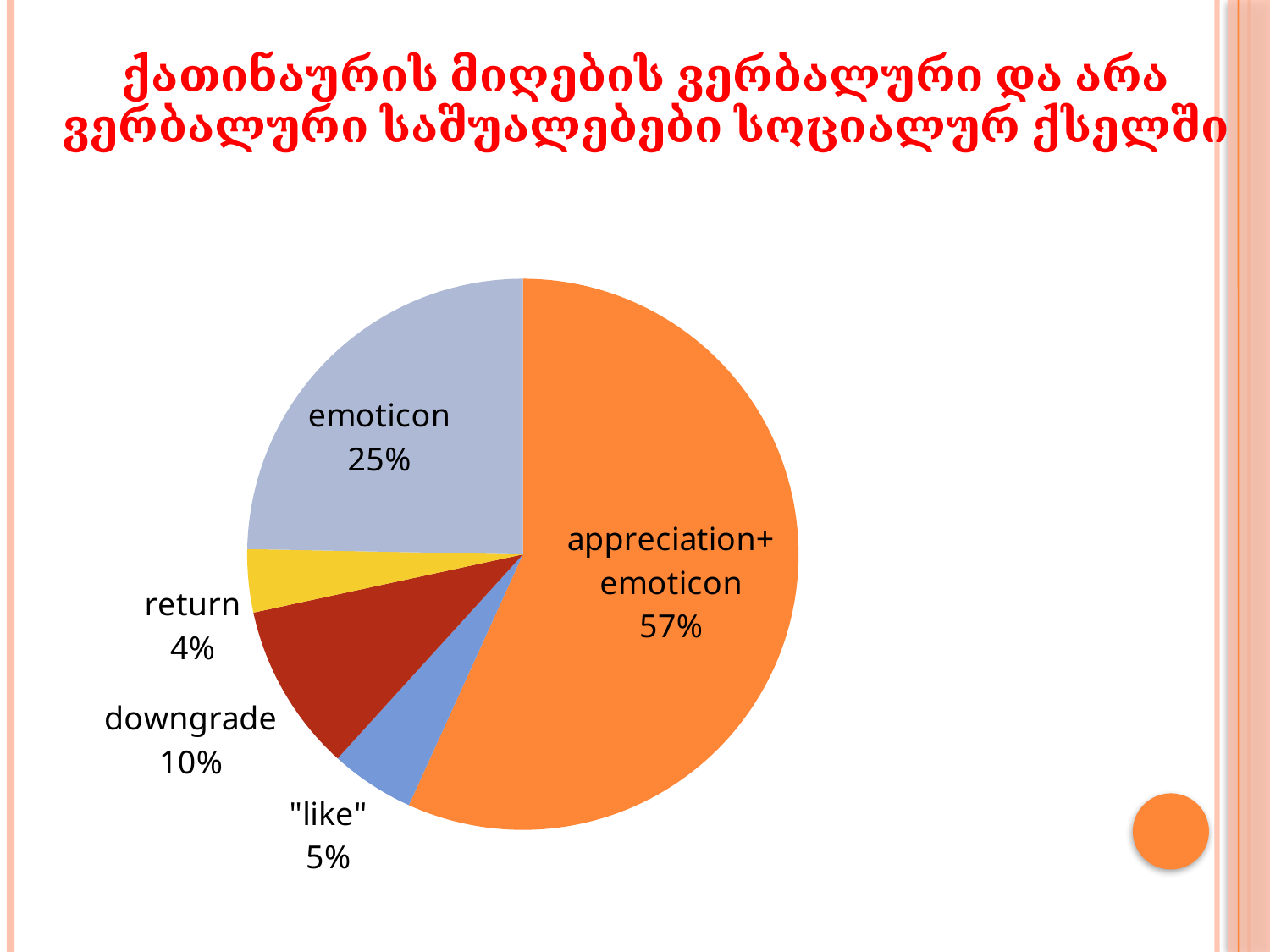
Which slice of the pie is the smallest? return How many slices does the pie chart have? 5 What share of the pie does "emoticon" have? 25% What is the value shown for "return"? 4% Which slice of the pie is the largest? appreciation+ emoticon What share of the pie does "appreciation+ emoticon" have? 57% What is the difference between the "appreciation+ emoticon" share and the "emoticon" share? 32% What is the value shown for "downgrade"? 10% Which is larger, the "downgrade" slice or the "like" slice? downgrade What is the value shown for "like"? 5% What colour is the "emoticon" slice? light blue-grey What kind of chart is shown on the slide? pie chart